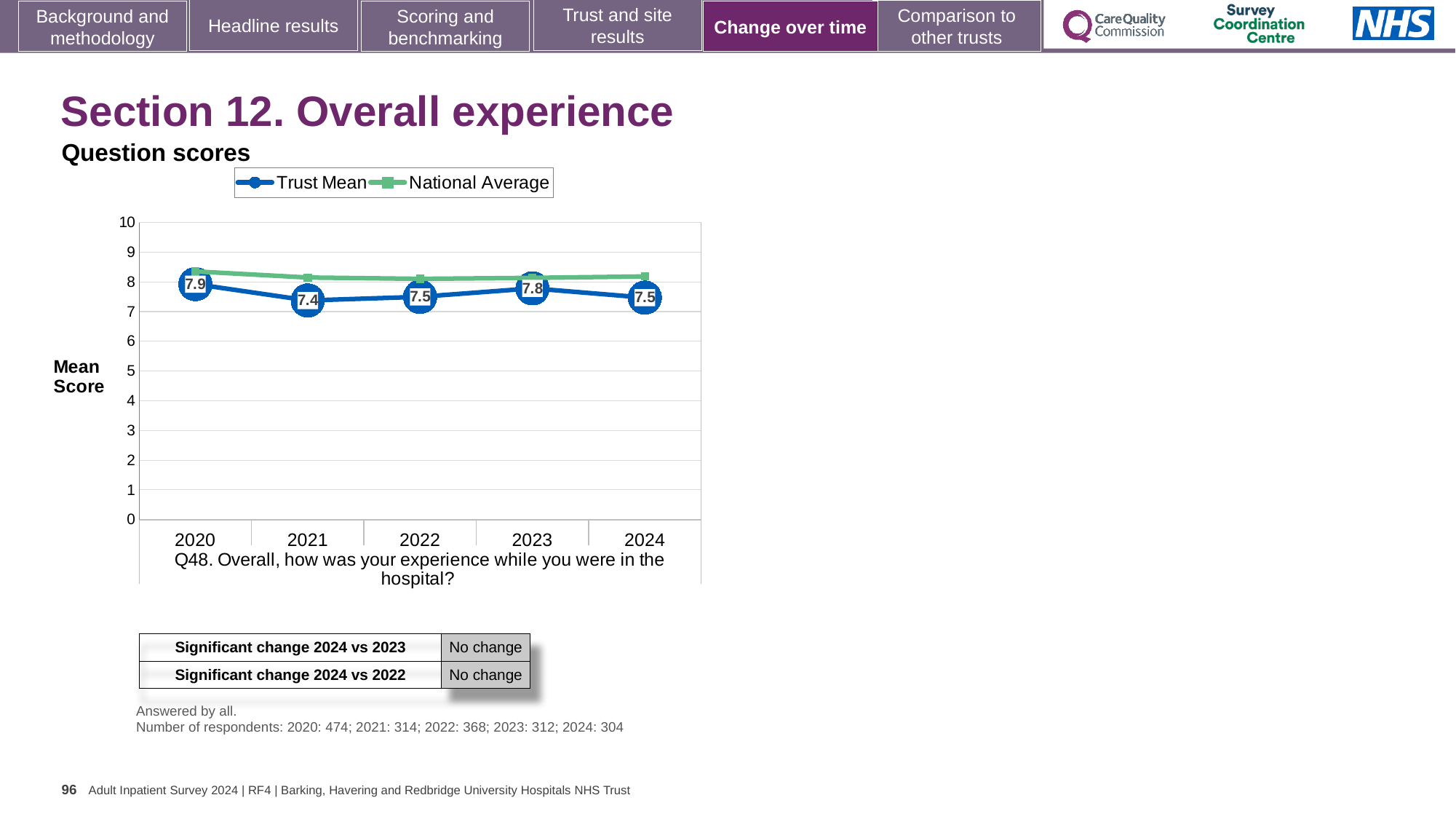
What is the Trust Mean score for 2021? 7.4 Which is larger, the Trust Mean score for 2023 or for 2024? 2023 What is the difference between the Trust Mean scores for 2020 and 2021? 0.5 How many series does the chart legend list? 2 How many years are shown on the x axis of the chart? 5 Is the National Average value for 2020 greater or less than 8? greater In which year is the Trust Mean score lowest? 2021 What is the Trust Mean score for 2024? 7.5 What is the Trust Mean score for 2023? 7.8 What kind of chart is shown on the slide? Line chart In which year is the Trust Mean score highest? 2020 What is the Trust Mean score for 2020? 7.9